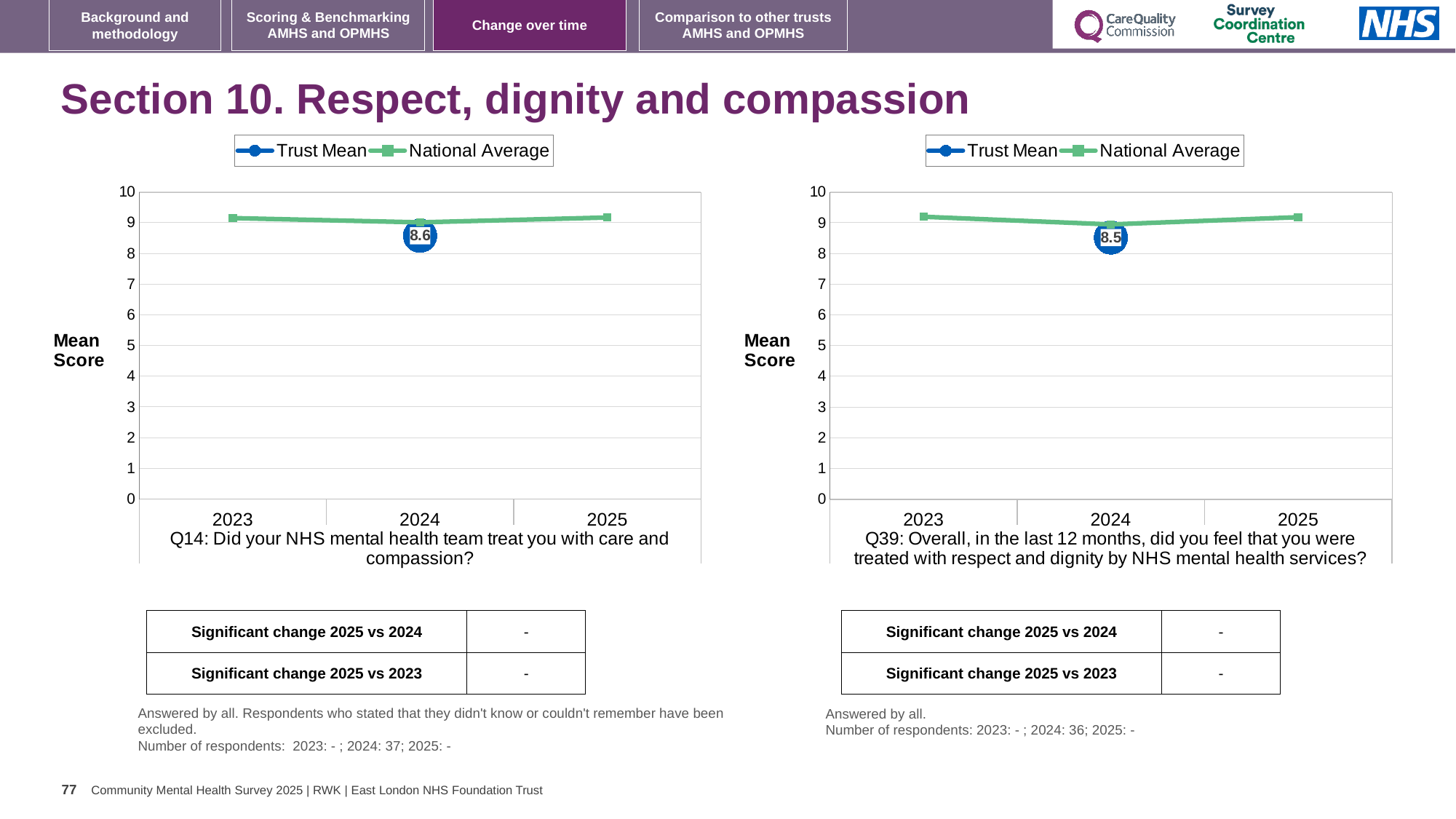
In the left chart (Q14), what is the Trust Mean value for 2024? 8.6 Which chart has the higher Trust Mean value for 2024: the left chart (Q14) or the right chart (Q39)? The left chart (Q14) In the right chart (Q39), is the National Average value for 2025 greater or less than 10? less What is the y-axis label of the right chart (Q39)? Mean Score In the right chart (Q39), what is the Trust Mean value for 2024? 8.5 How many series does the legend of the right chart (Q39) list? 2 In the left chart (Q14), is the National Average value for 2023 greater or less than 8? greater What are the two series named in the legend of the left chart (Q14)? Trust Mean and National Average In the right chart (Q39), is the Trust Mean value for 2024 greater or less than 9? less In the left chart (Q14), which is higher in 2024: the Trust Mean or the National Average? National Average What kind of chart is the left chart (Q14)? Line chart How many years are shown on the x axis of the left chart (Q14)? 3